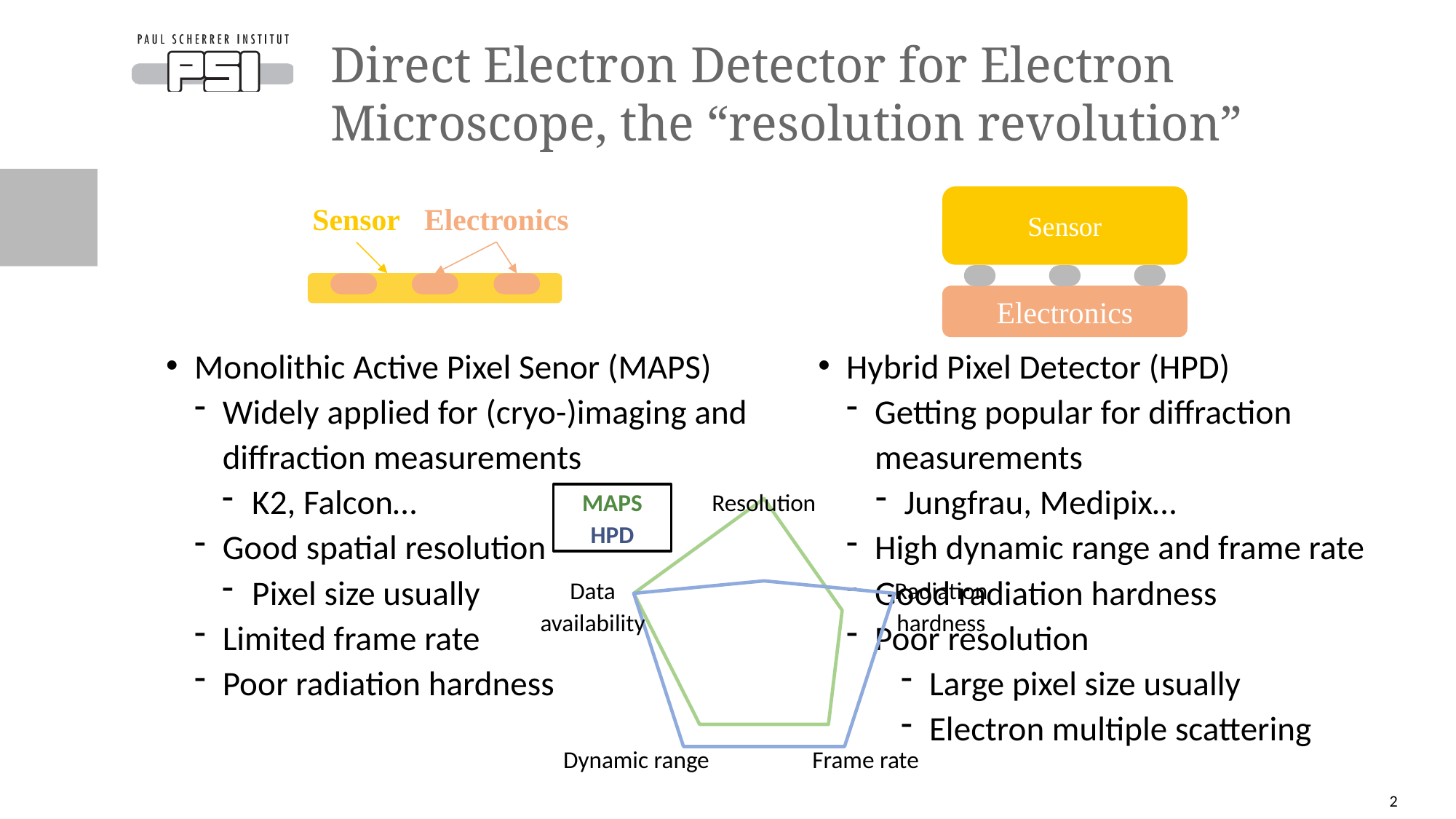
What kind of chart is shown at the bottom centre of the slide? Radar chart On which axis of the radar chart does the HPD series reach its lowest value? Resolution What colour is used for the HPD series in the radar chart? Blue How many axes (categories) does the radar chart have? 5 On which axis of the radar chart does the MAPS series reach its highest value? Resolution and Data availability (tied) How many series does the legend of the radar chart list? 2 Which series scores higher on the Resolution axis of the radar chart, MAPS or HPD? MAPS Which series scores higher on the Frame rate axis of the radar chart, MAPS or HPD? HPD Which series scores higher on the Dynamic range axis of the radar chart, MAPS or HPD? HPD What colour is used for the MAPS series in the radar chart? Green